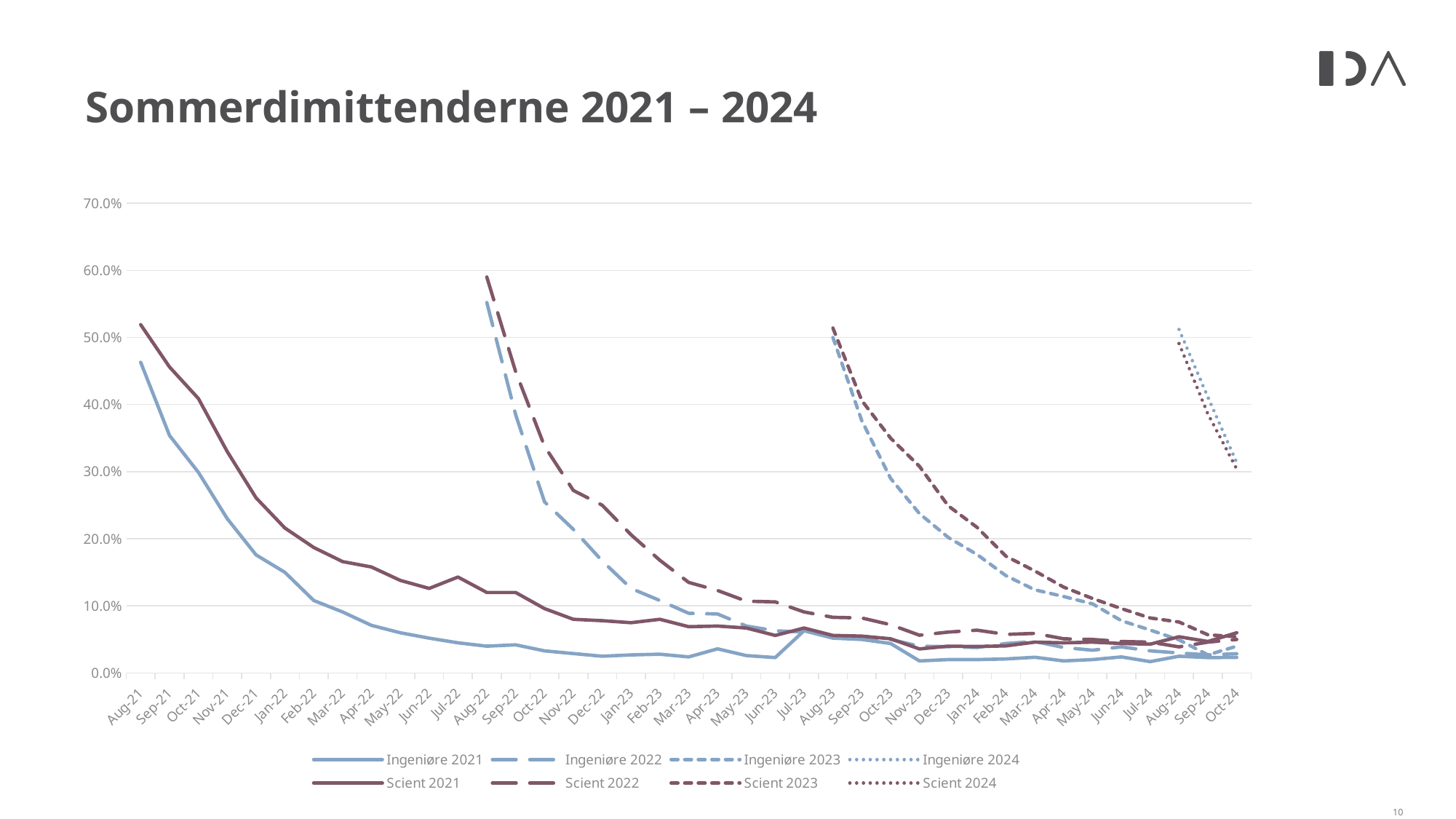
At Nov-22, which is higher: Scient 2022 or Ingeniøre 2022? Scient 2022 Is the value for Ingeniøre 2021 at Dec-21 greater or less than 20%? less At Aug-21, which is higher: Scient 2021 or Ingeniøre 2021? Scient 2021 How many series does the legend list? 8 Which series reaches the highest value on the chart? Scient 2022 Is the value for Ingeniøre 2021 at Aug-21 greater or less than 50%? less What kind of chart is shown on the slide? Line chart Is the value for Scient 2022 at Aug-22 greater or less than 50%? greater Do the values of the Ingeniøre 2021 series rise or fall from Aug-21 to Oct-24? Fall What is the title of the chart? Sommerdimittenderne 2021 – 2024 What is the highest value shown on the vertical axis? 70.0%